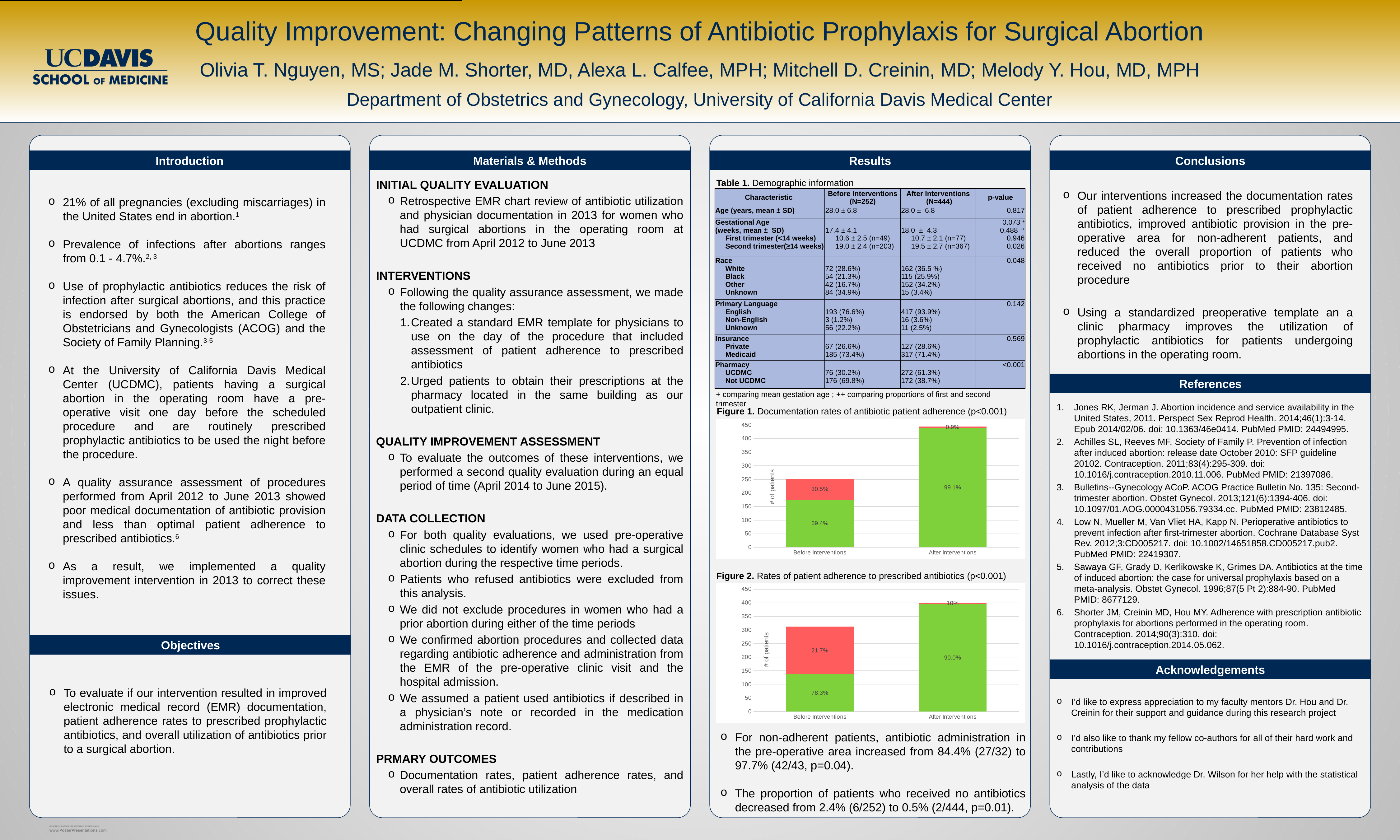
In Figure 2 (Rates of patient adherence to prescribed antibiotics), what percentage is labelled on the red segment of the Before Interventions bar? 21.7% In Figure 2 (Rates of patient adherence to prescribed antibiotics), what percentage is labelled on the green segment of the Before Interventions bar? 78.3% In Figure 1 (Documentation rates of antibiotic patient adherence), what percentage is labelled on the green segment of the Before Interventions bar? 69.4% How many categories are shown on the x axis of Figure 1 (Documentation rates of antibiotic patient adherence)? 2 In Figure 1 (Documentation rates of antibiotic patient adherence), is the total height of the After Interventions bar greater or less than 400 patients? greater In Figure 1 (Documentation rates of antibiotic patient adherence), what percentage is labelled on the red segment of the Before Interventions bar? 30.5% What kind of chart is Figure 2 (Rates of patient adherence to prescribed antibiotics)? stacked bar chart In Figure 2 (Rates of patient adherence to prescribed antibiotics), what percentage is labelled on the green segment of the After Interventions bar? 90.0% In Figure 2 (Rates of patient adherence to prescribed antibiotics), what is the difference between the green-segment percentages for After Interventions and Before Interventions? 11.7% In Figure 1 (Documentation rates of antibiotic patient adherence), what percentage is labelled on the red segment of the After Interventions bar? 0.9% In Figure 2 (Rates of patient adherence to prescribed antibiotics), is the total height of the Before Interventions bar greater or less than 350 patients? less In Figure 1 (Documentation rates of antibiotic patient adherence), what percentage is labelled on the green segment of the After Interventions bar? 99.1%